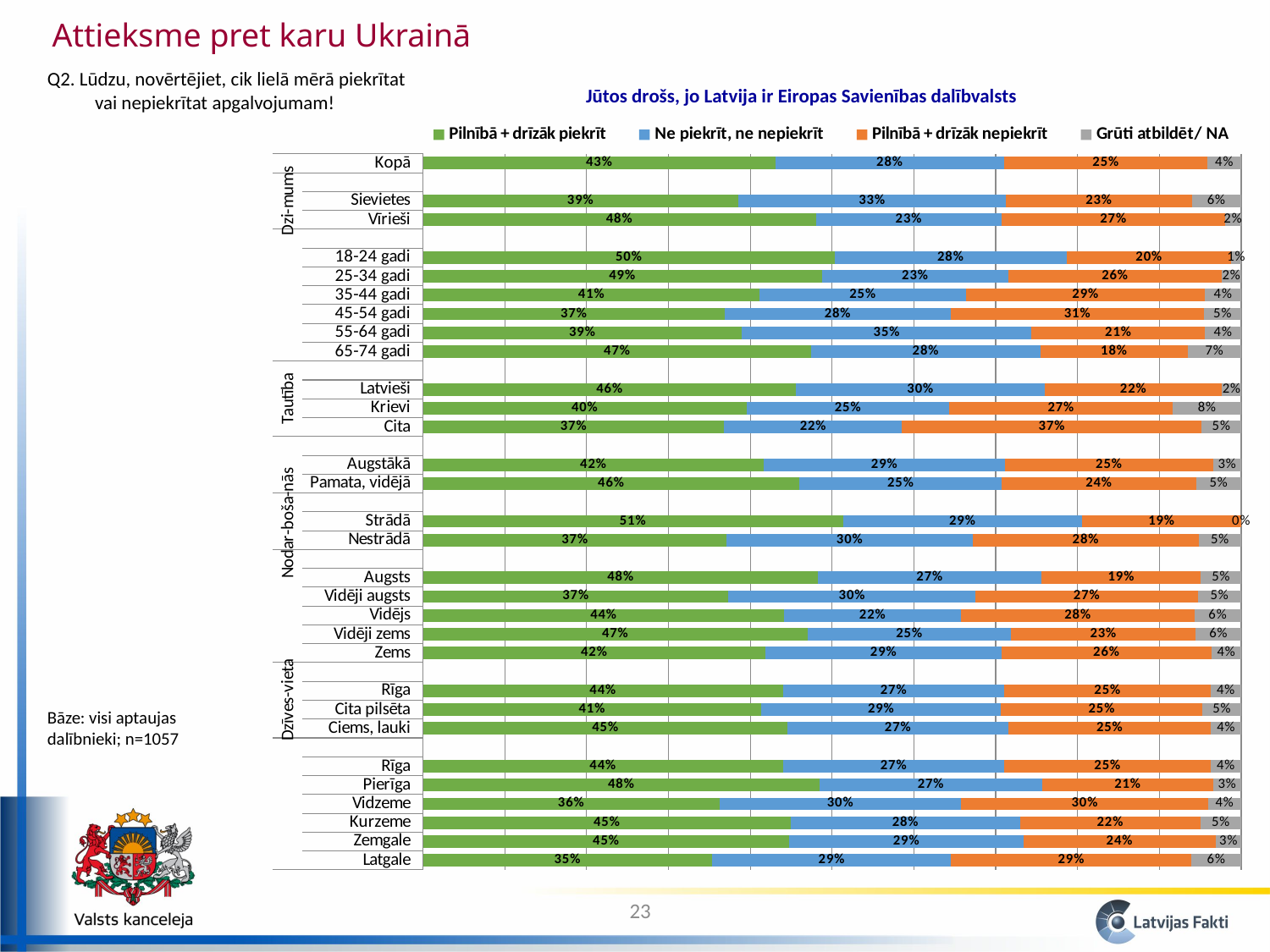
What is the title of the chart? Jūtos drošs, jo Latvija ir Eiropas Savienības dalībvalsts What is the value of "Pilnībā + drīzāk nepiekrīt" for Cita (Tautība)? 37% What is the difference between the "Pilnībā + drīzāk piekrīt" values for Vīrieši and Sievietes? 9 percentage points Which category has the lowest value for "Pilnībā + drīzāk piekrīt"? Latgale How many series does the legend list? 4 What is the value of "Grūti atbildēt/ NA" for Krievi? 8% Which has a larger "Pilnībā + drīzāk piekrīt" value, Latvieši or Krievi? Latvieši What is the value of "Pilnībā + drīzāk piekrīt" for Kopā? 43% Which category has the highest value for "Pilnībā + drīzāk piekrīt"? Strādā What is the value of "Ne piekrīt, ne nepiekrīt" for 55-64 gadi? 35% What kind of chart is shown on the slide? Stacked bar chart Which category has the lowest value for "Grūti atbildēt/ NA"? Strādā